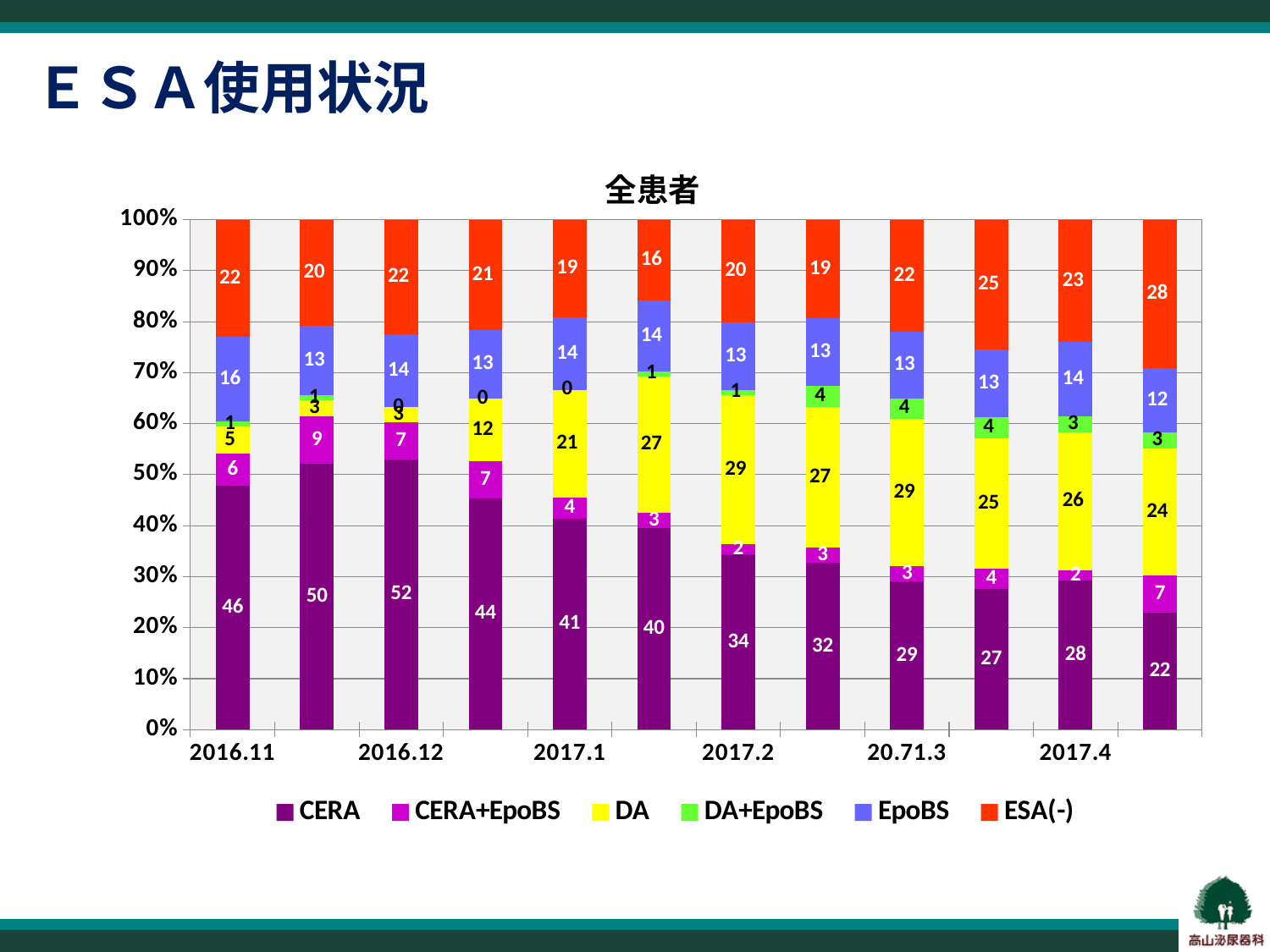
Which series has the largest segment in the 2016.11 bar? CERA How many series does the legend list? 6 What is the value of the EpoBS segment for 2017.4? 14 Which is larger, the DA value for 2016.12 or the DA value for 2017.1? 2017.1 What is the total of all segments in the 2016.11 bar? 96 What is the value of the ESA(-) segment for 2017.1? 19 What is the value of the DA segment for 2017.2? 29 Which series has the smallest segment in the 2017.1 bar? DA+EpoBS What kind of chart is shown on the slide? Stacked bar chart What is the value of the CERA segment for 2016.11? 46 What is the difference between the CERA values for 2016.12 and 2017.4? 24 Does the CERA value rise or fall from 2016.12 to 2017.4? Fall